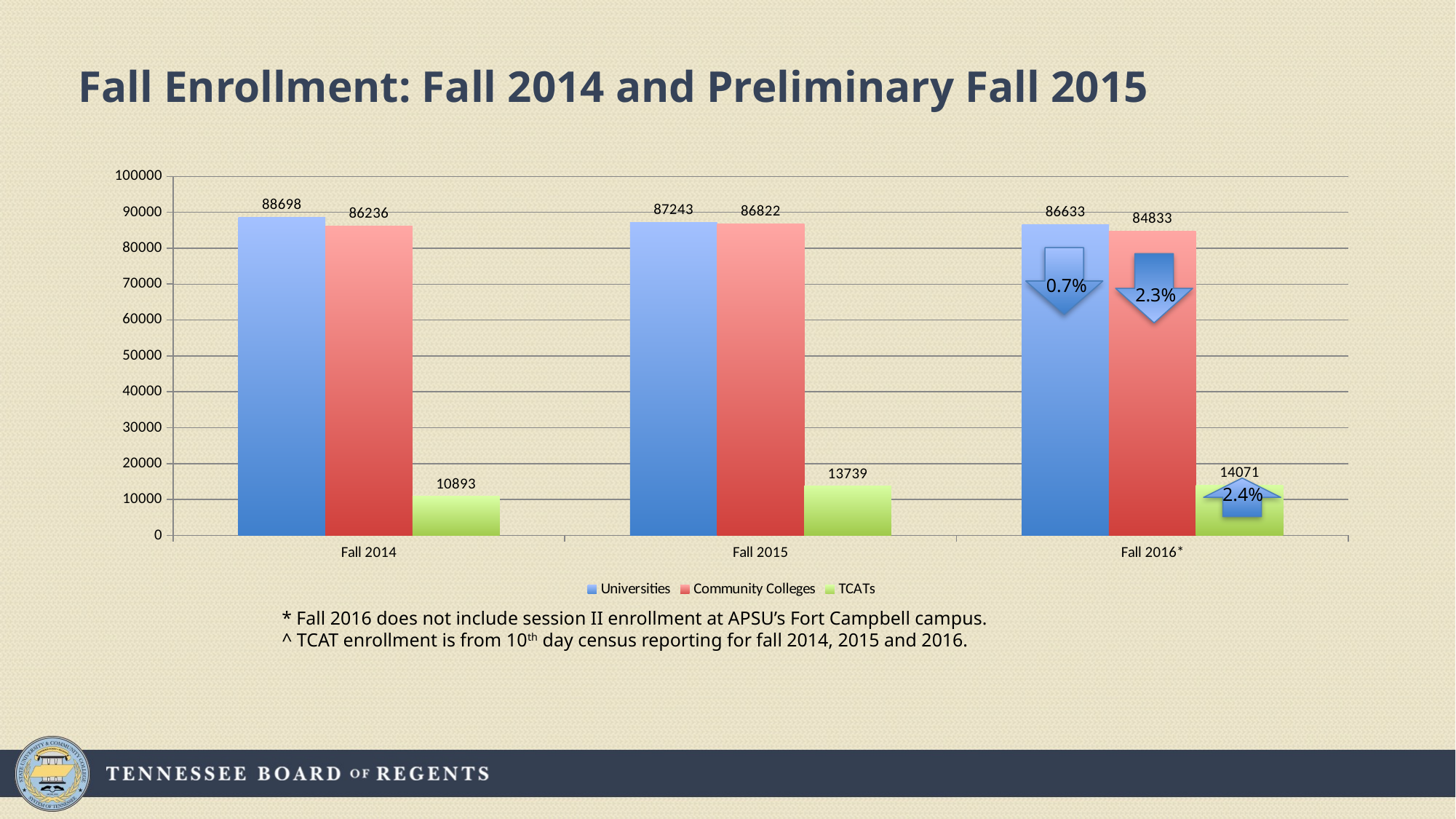
Which is larger in Fall 2016*: Universities or Community Colleges enrollment? Universities In which year is Universities enrollment highest? Fall 2014 What is the difference between Universities and Community Colleges enrollment in Fall 2014? 2462 What kind of chart is shown on the slide? Bar chart What is the Community Colleges enrollment for Fall 2015? 86822 How many series does the legend list? 3 Does TCATs enrollment rise or fall from Fall 2014 to Fall 2016*? Rise How many year categories are shown on the x axis? 3 Which series has the lowest enrollment in Fall 2015? TCATs What is the TCATs enrollment for Fall 2016*? 14071 Is the TCATs value for Fall 2014 greater or less than 20000? less What is the Universities enrollment for Fall 2014? 88698